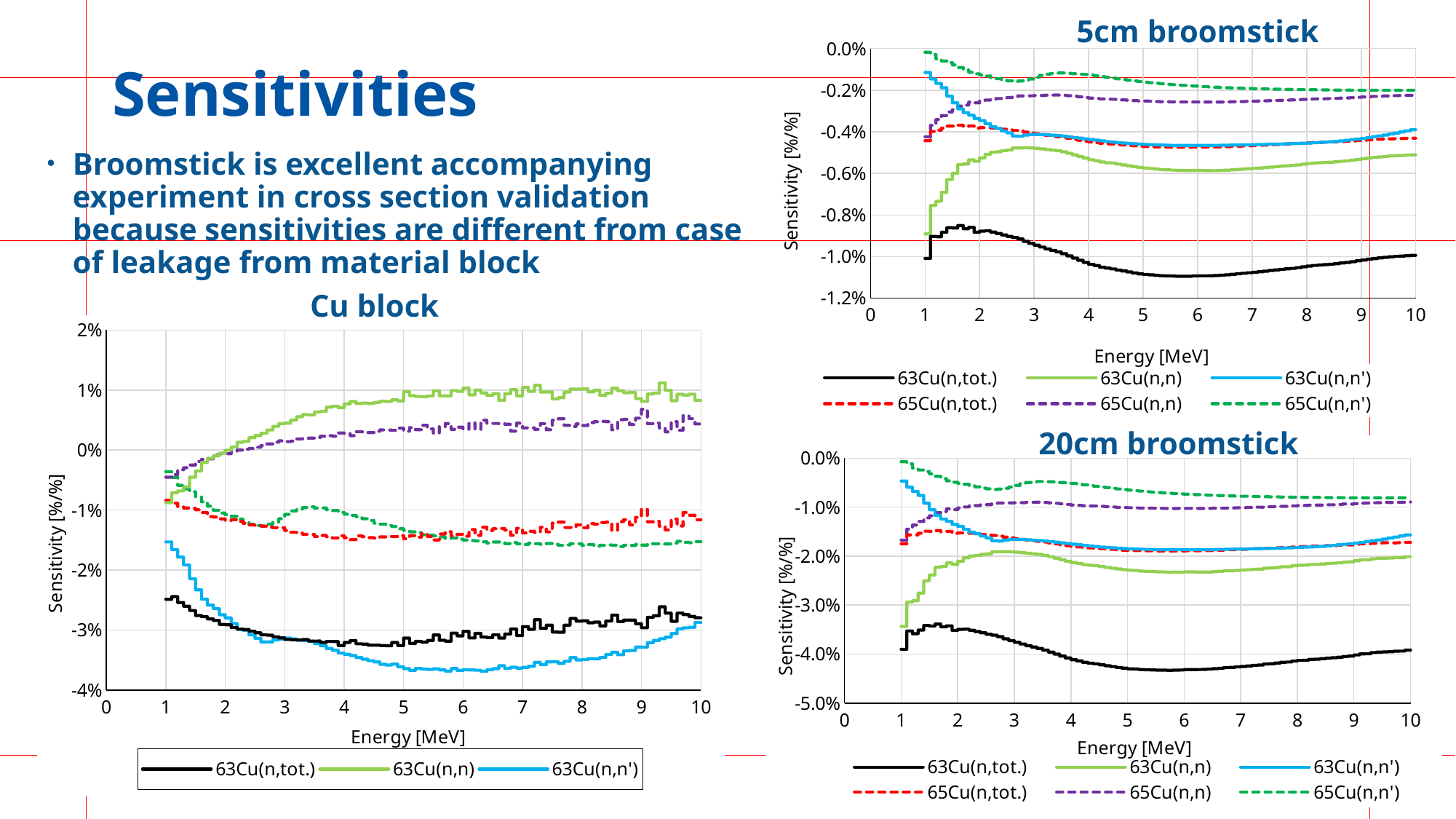
How many series does the legend of the "Cu block" chart list? 3 In the "Cu block" chart, is the value of 63Cu(n,n') at 6 MeV greater or less than -3%? less In the "Cu block" chart, does the 63Cu(n,n) series rise or fall between 1 MeV and 5 MeV? rise What kind of chart is the "Cu block" chart? line chart In the "20cm broomstick" chart, is the value of 63Cu(n,tot.) at 6 MeV greater or less than -4.0%? less In the "5cm broomstick" chart, is the value of 63Cu(n,tot.) at 6 MeV greater or less than -1.0%? less What is the x-axis label of the "20cm broomstick" chart? Energy [MeV] In the "Cu block" chart, which is larger at 6 MeV: 63Cu(n,tot.) or 63Cu(n,n')? 63Cu(n,tot.) In the "Cu block" chart, which series has the highest sensitivity at 6 MeV? 63Cu(n,n) In the "5cm broomstick" chart, which series has the lowest (most negative) sensitivity across the energy range? 63Cu(n,tot.) How many series does the legend of the "5cm broomstick" chart list? 6